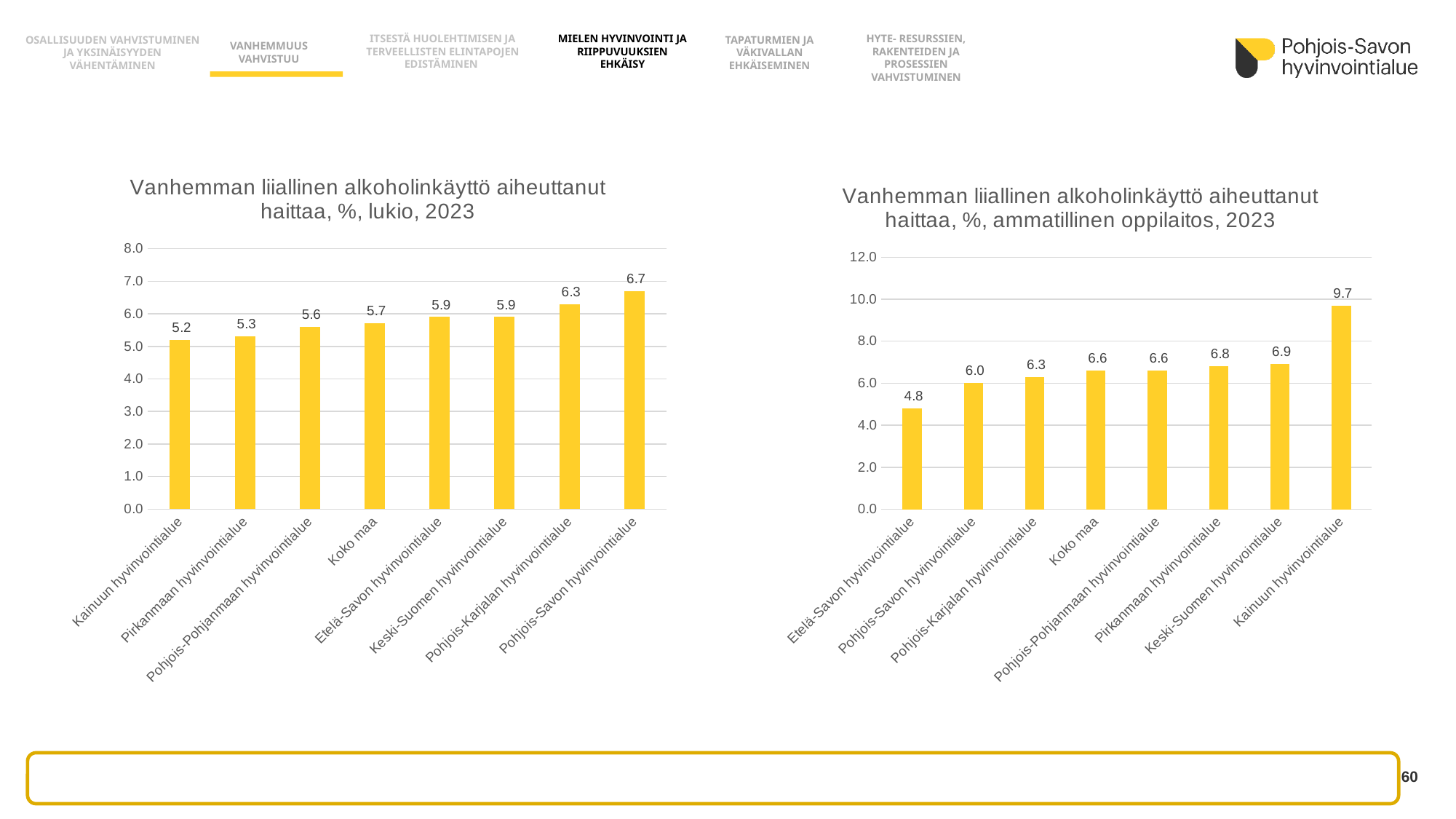
What type of chart is the right chart (ammatillinen oppilaitos, 2023)? bar chart In the left chart (lukio, 2023), which category has the lowest value? Kainuun hyvinvointialue In the left chart (lukio, 2023), how many categories are shown? 8 In the left chart (lukio, 2023), what is the value for Koko maa? 5.7 In the left chart (lukio, 2023), what is the value for Pohjois-Savon hyvinvointialue? 6.7 In the right chart (ammatillinen oppilaitos, 2023), what is the value for Etelä-Savon hyvinvointialue? 4.8 In the left chart (lukio, 2023), what is the difference between Pohjois-Savon hyvinvointialue and Kainuun hyvinvointialue? 1.5 In the right chart (ammatillinen oppilaitos, 2023), what is the difference between Kainuun hyvinvointialue and Koko maa? 3.1 In the right chart (ammatillinen oppilaitos, 2023), what is the value for Kainuun hyvinvointialue? 9.7 In the right chart (ammatillinen oppilaitos, 2023), which is larger: Pohjois-Savon hyvinvointialue or Keski-Suomen hyvinvointialue? Keski-Suomen hyvinvointialue In the right chart (ammatillinen oppilaitos, 2023), which category has the highest value? Kainuun hyvinvointialue In the left chart (lukio, 2023), do the values rise or fall from left to right? rise